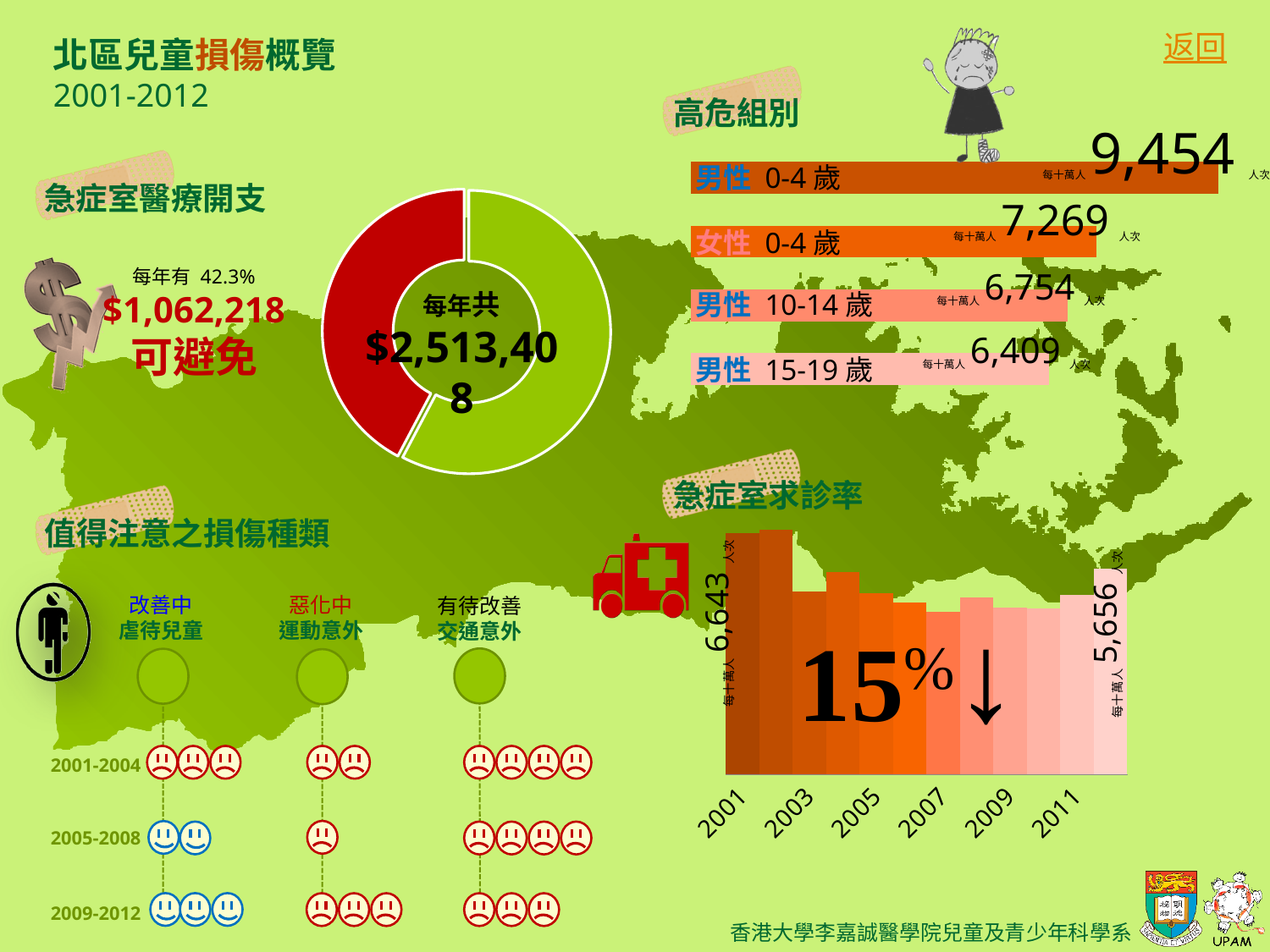
In the 值得注意之損傷種類 pictograph, how many sad faces are shown for 交通意外 in 2005-2008? 4 In the 高危組別 bar chart, what is the value for 男性 0-4 歲? 9,454 In the 急症室求診率 bar chart, what is the value labelled on the 2001 bar? 6,643 In the 高危組別 bar chart, what is the difference between 男性 0-4 歲 and 女性 0-4 歲? 2,185 How many groups are shown in the 高危組別 bar chart? 4 In the 急症室醫療開支 donut chart, what share of the annual expenditure is marked as avoidable (可避免)? 42.3% In the 高危組別 bar chart, what is the value for 女性 0-4 歲? 7,269 In the 急症室求診率 bar chart, what is the value labelled on the last bar? 5,656 In the 高危組別 bar chart, which group has the lowest value? 男性 15-19 歲 In the 急症室醫療開支 donut chart, what is the total annual amount shown in the centre? $2,513,408 In the 急症室求診率 bar chart, do the values overall rise or fall from 2001 to the last year? Fall What kind of chart is used for 急症室醫療開支? Donut (pie) chart